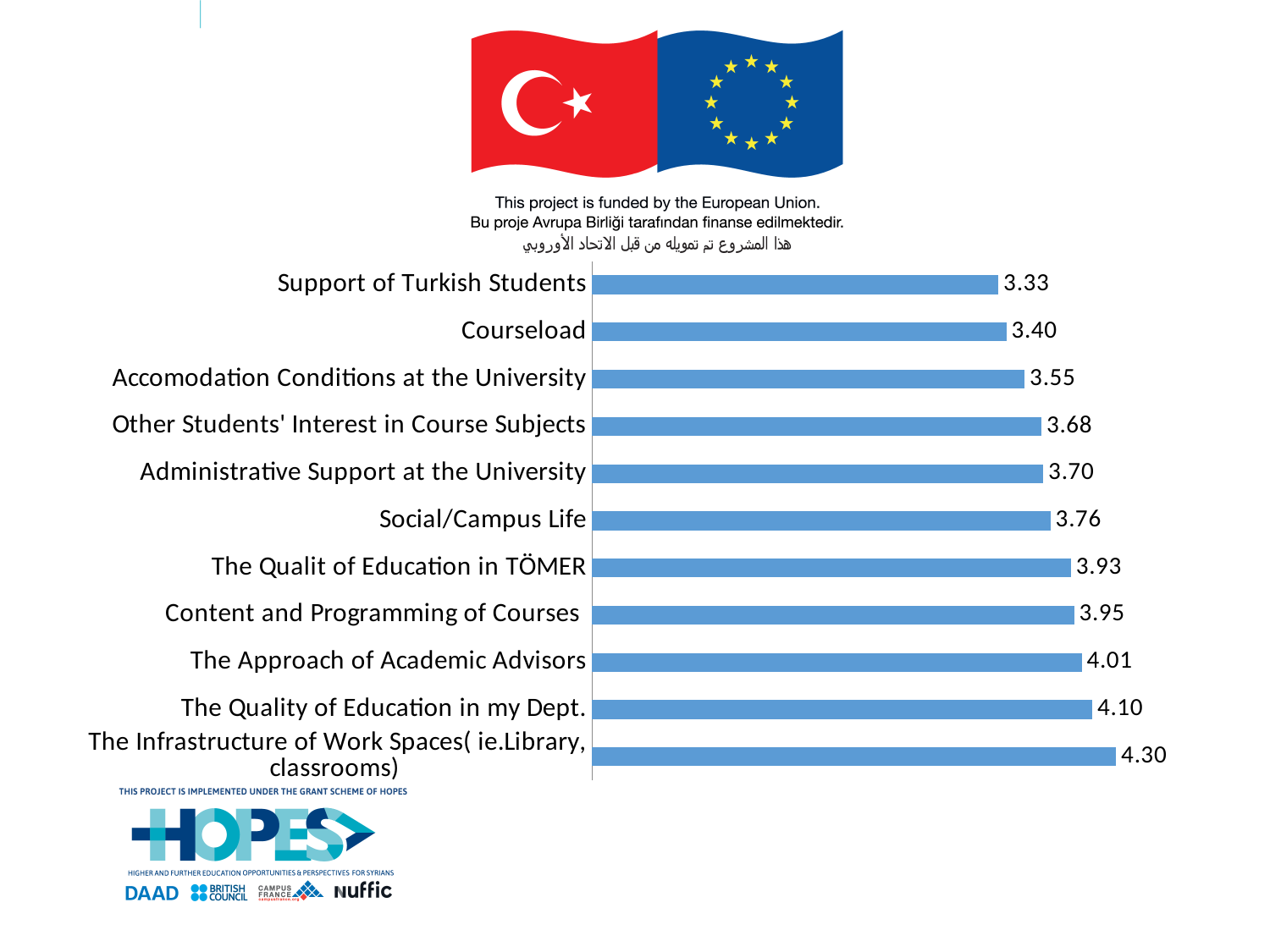
What is the value for Administrative Support at the University? 3.70 What kind of chart is shown on the slide? Bar chart What is the difference between the values for The Qualit of Education in TÖMER and Other Students' Interest in Course Subjects? 0.25 What is the value for Social/Campus Life? 3.76 Which category has the highest value? The Infrastructure of Work Spaces( ie.Library, classrooms) Which category has the lowest value? Support of Turkish Students What is the value for Courseload? 3.40 How many categories are shown in the chart? 11 Which has a larger value, Accomodation Conditions at the University or Content and Programming of Courses? Content and Programming of Courses What colour are the bars in the chart? Blue What is the difference between the values for The Quality of Education in my Dept. and Support of Turkish Students? 0.77 What is the value for The Approach of Academic Advisors? 4.01